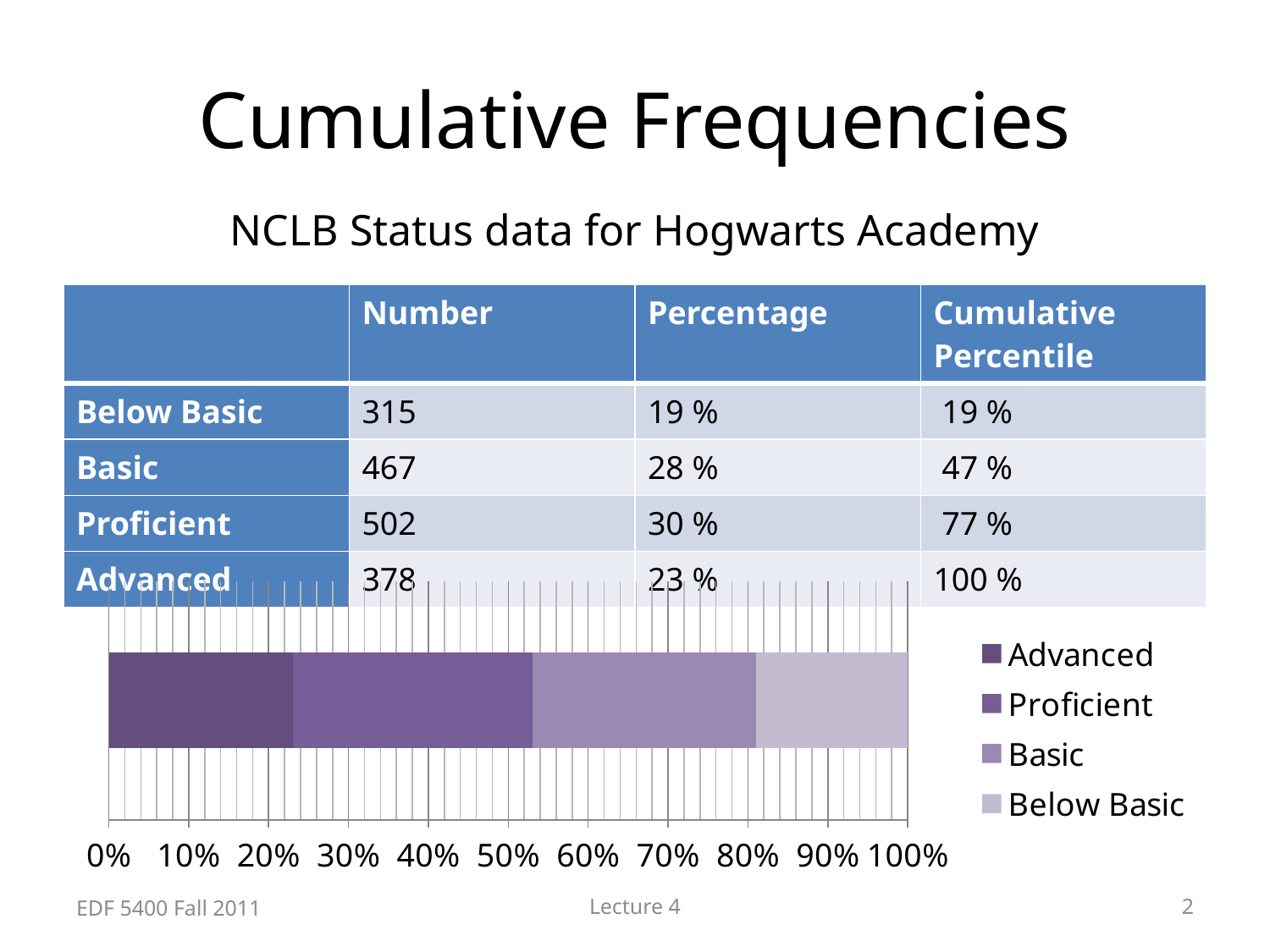
How many segments make up the stacked bar in the chart? 4 Which series is listed first in the chart legend? Advanced Is the width of the Below Basic segment in the bar greater or less than 30%? less Is the width of the Proficient segment in the bar greater or less than 20%? greater Which series is drawn in the darkest purple in the chart? Advanced What is the total of the stacked bar, as shown by where it ends on the axis? 100% Which segment is wider in the bar, Proficient or Below Basic? Proficient Which segment is wider in the bar, Basic or Advanced? Basic How many series does the chart legend list? 4 Is the width of the Advanced segment in the bar greater or less than 30%? less What kind of chart is shown on the slide? stacked bar chart